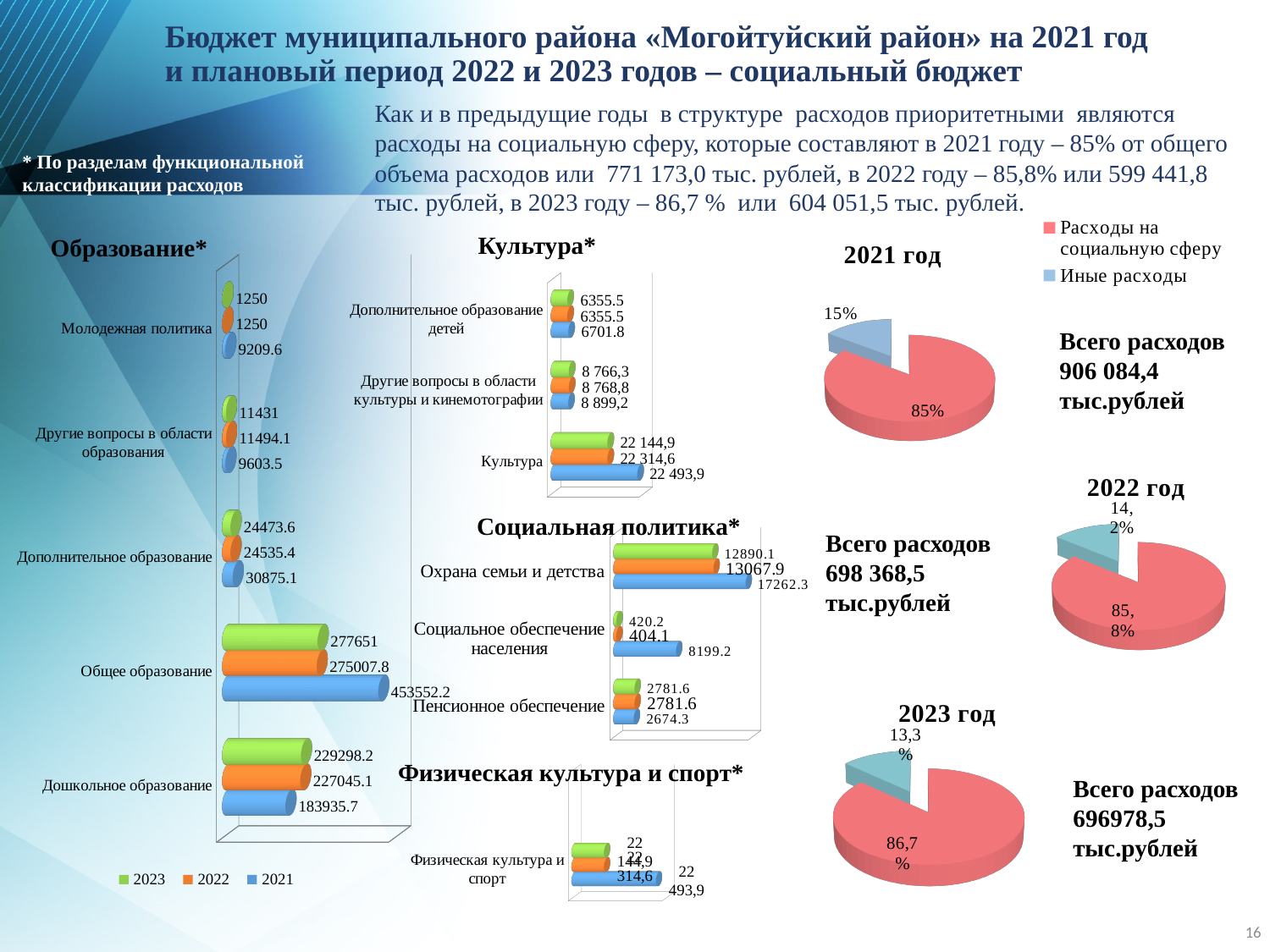
On the «Образование*» chart, what is the 2021 value for Общее образование? 453552.2 On the «Образование*» chart, what is the 2023 value for Дошкольное образование? 229298.2 On the «2021 год» pie chart, what share is Расходы на социальную сферу? 85% How many categories are shown on the «Образование*» chart? 5 On the «Образование*» chart, which category has the highest 2021 value? Общее образование On the «Социальная политика*» chart, what is the 2021 value for Социальное обеспечение населения? 8199.2 On the «Культура*» chart, what is the difference between the 2021 and 2023 values for Дополнительное образование детей? 346.3 On the «Социальная политика*» chart, which is larger for Охрана семьи и детства: the 2022 value or the 2023 value? 2022 On the «2023 год» pie chart, what share is Иные расходы? 13,3% What kind of chart is the «Образование*» chart? bar chart How many series does the legend of the «Образование*» chart list? 3 On the «Культура*» chart, what is the 2021 value for Культура? 22 493,9